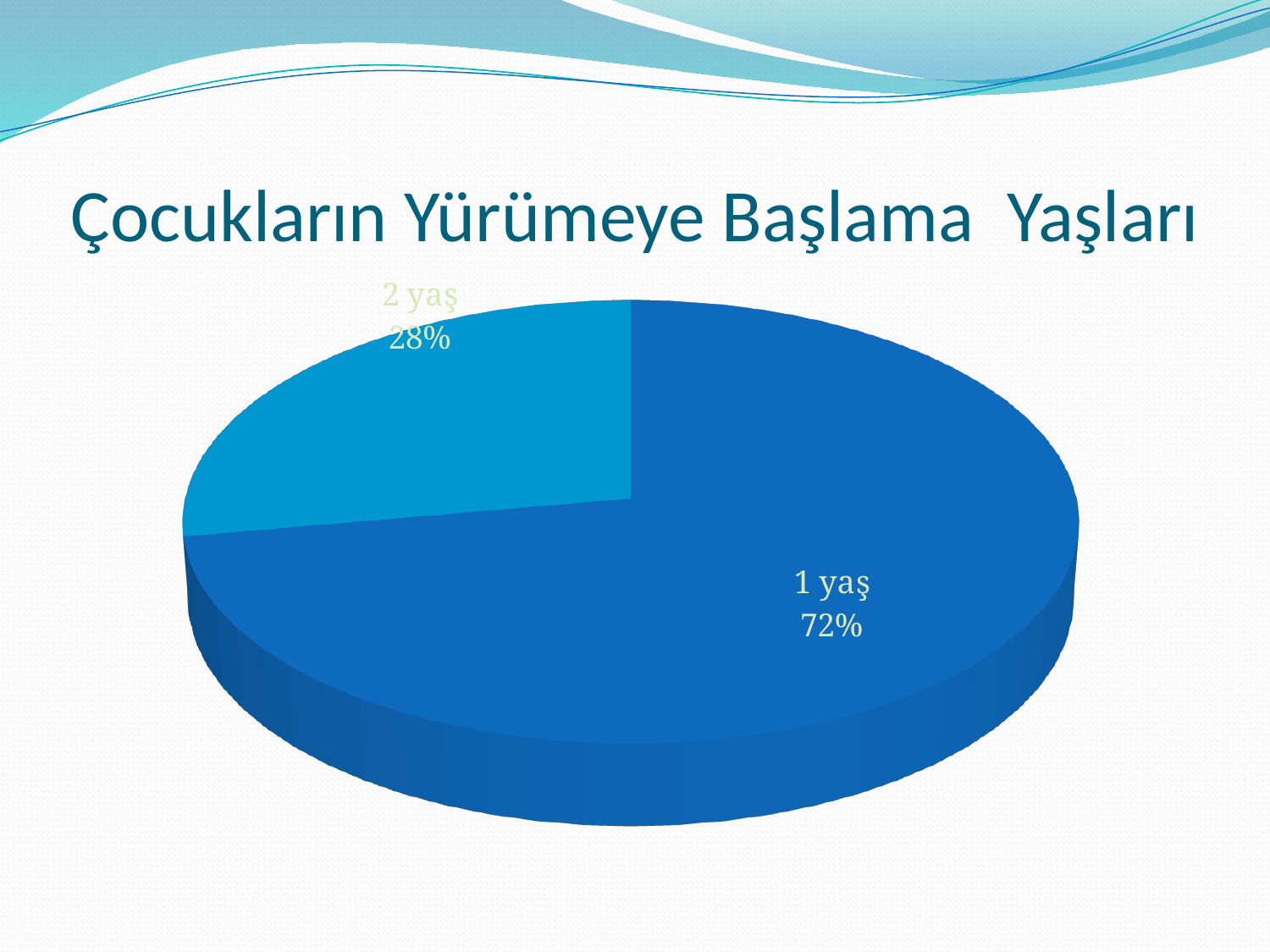
Which category has the smallest share of the pie? 2 yaş What is the title of the chart? Çocukların Yürümeye Başlama Yaşları How many slices does the pie chart have? 2 Which slice is larger, "1 yaş" or "2 yaş"? 1 yaş What is the difference in percentage points between the "1 yaş" and "2 yaş" slices? 44 What percentage of the pie is labelled "2 yaş"? 28% What percentage of the pie is labelled "1 yaş"? 72% What kind of chart is shown on the slide? pie chart Which category has the largest share of the pie? 1 yaş Is the share for "1 yaş" greater or less than 50%? greater What share of the pie does the "2 yaş" slice represent? 28%